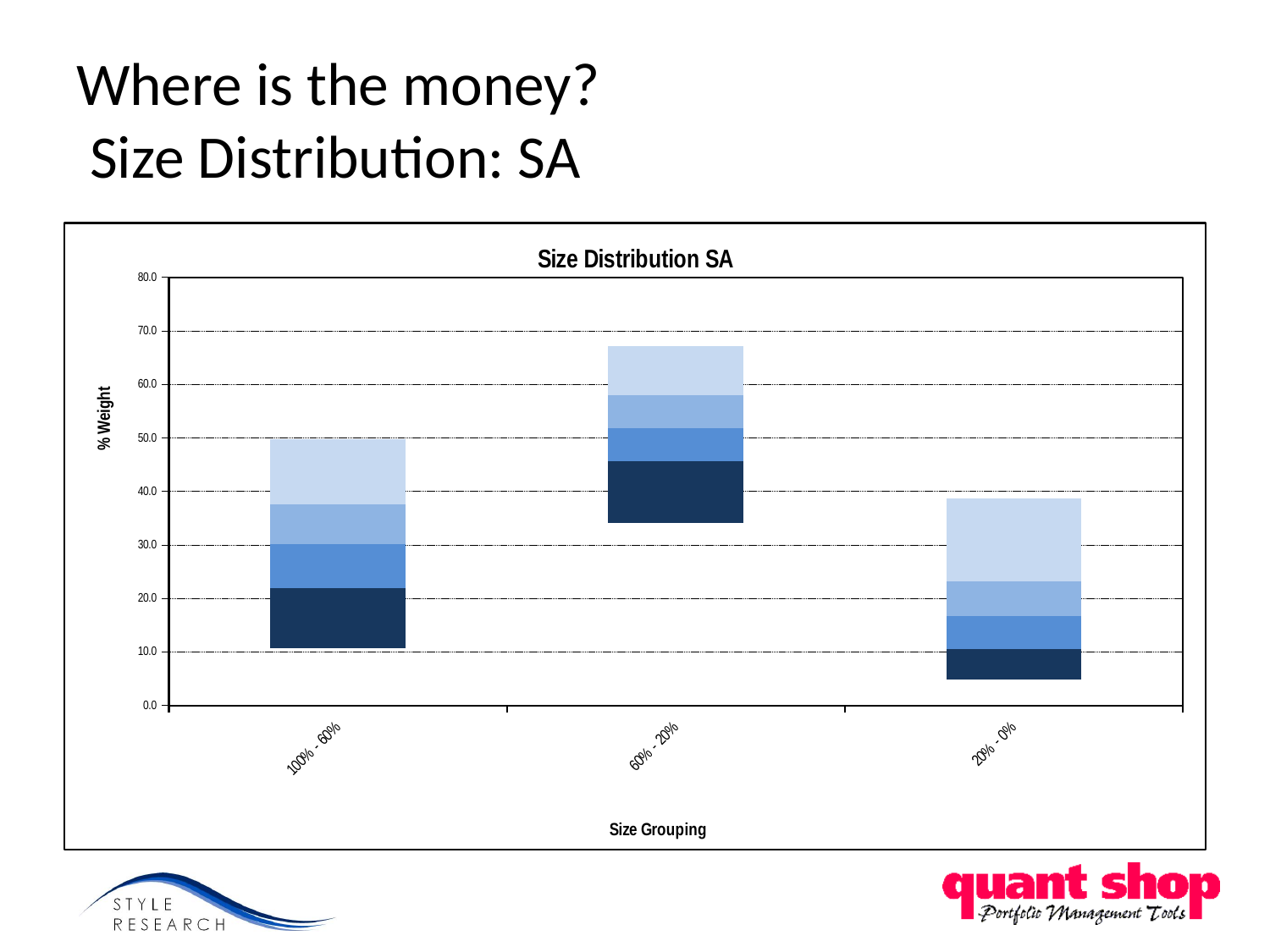
Is the top of the bar for 60% - 20% greater or less than 60.0? greater Which size grouping has the bar that reaches the lowest % Weight? 20% - 0% What is the title of the chart? Size Distribution SA Which bar reaches higher on the % Weight axis, 100% - 60% or 20% - 0%? 100% - 60% How many size grouping categories are shown on the x axis? 3 Is the top of the bar for 20% - 0% greater or less than 50.0? less Is the bottom of the bar for 20% - 0% greater or less than 10.0? less Which size grouping has the bar that reaches the highest % Weight? 60% - 20% What kind of chart is shown on the slide? Stacked bar chart What is the label of the vertical axis? % Weight